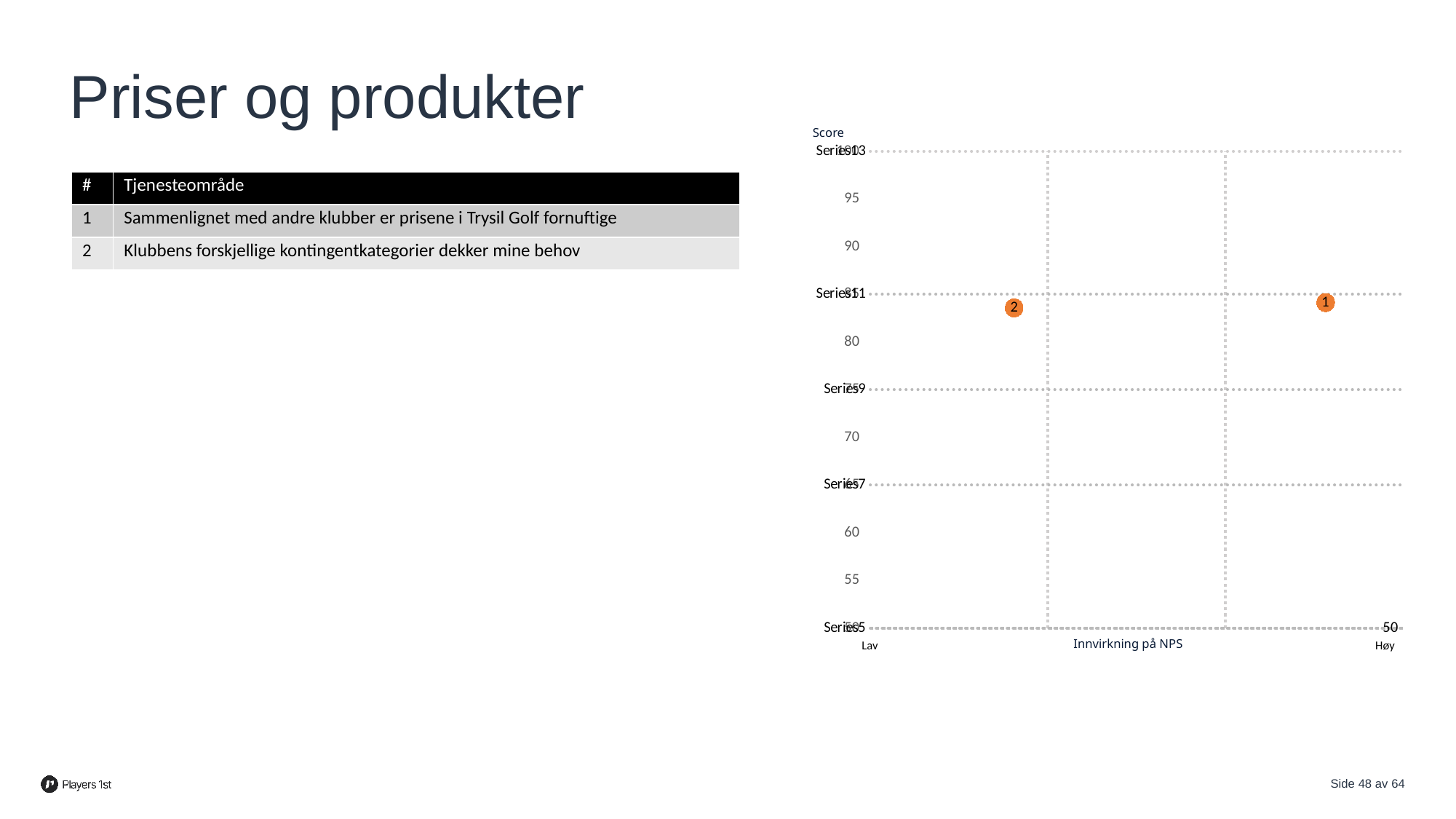
What is the label of the horizontal axis of the chart? Innvirkning på NPS Which point is positioned furthest to the left on the Innvirkning på NPS axis? point 2 According to the table, which service area (Tjenesteområde) does point 1 on the chart represent? Sammenlignet med andre klubber er prisene i Trysil Golf fornuftige According to the table, which service area (Tjenesteområde) does point 2 on the chart represent? Klubbens forskjellige kontingentkategorier dekker mine behov Is the Score value for point 2 greater or less than 80? greater How many data points are plotted on the chart? 2 What is the label of the vertical axis of the chart? Score What kind of chart is shown on the slide? scatter chart Is the Score value for point 1 greater or less than 90? less Which point has the higher impact on NPS (Innvirkning på NPS), point 1 or point 2? point 1 Is the Score value for point 2 greater or less than 90? less